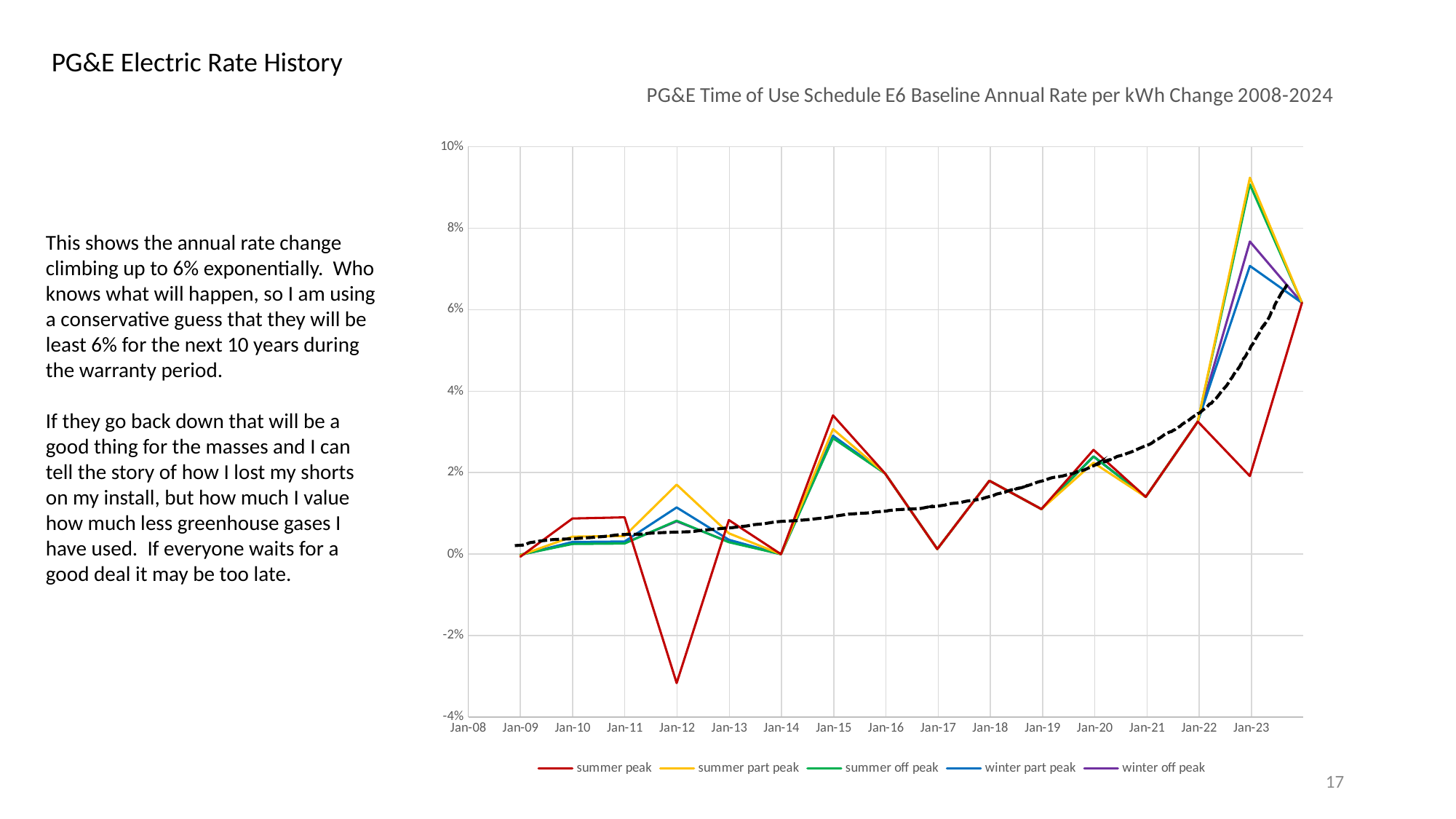
How many series does the chart legend list? 5 How many year labels are shown along the x axis of the chart? 16 What is the title of the chart? PG&E Time of Use Schedule E6 Baseline Annual Rate per kWh Change 2008-2024 What colour is the summer peak line in the chart? red At which x-axis date does the summer part peak series reach its highest value? Jan-23 Does the dashed trend line rise or fall from Jan-09 to Jan-23? rise Is the value for summer peak at Jan-15 greater or less than 2%? greater At which x-axis date does the summer peak series reach its lowest value? Jan-12 Is the value for summer part peak at Jan-23 greater or less than 8%? greater At Jan-23, which is larger: summer part peak or summer peak? summer part peak Is the value for summer peak at Jan-12 greater or less than -2%? less What kind of chart is shown on the slide? line chart